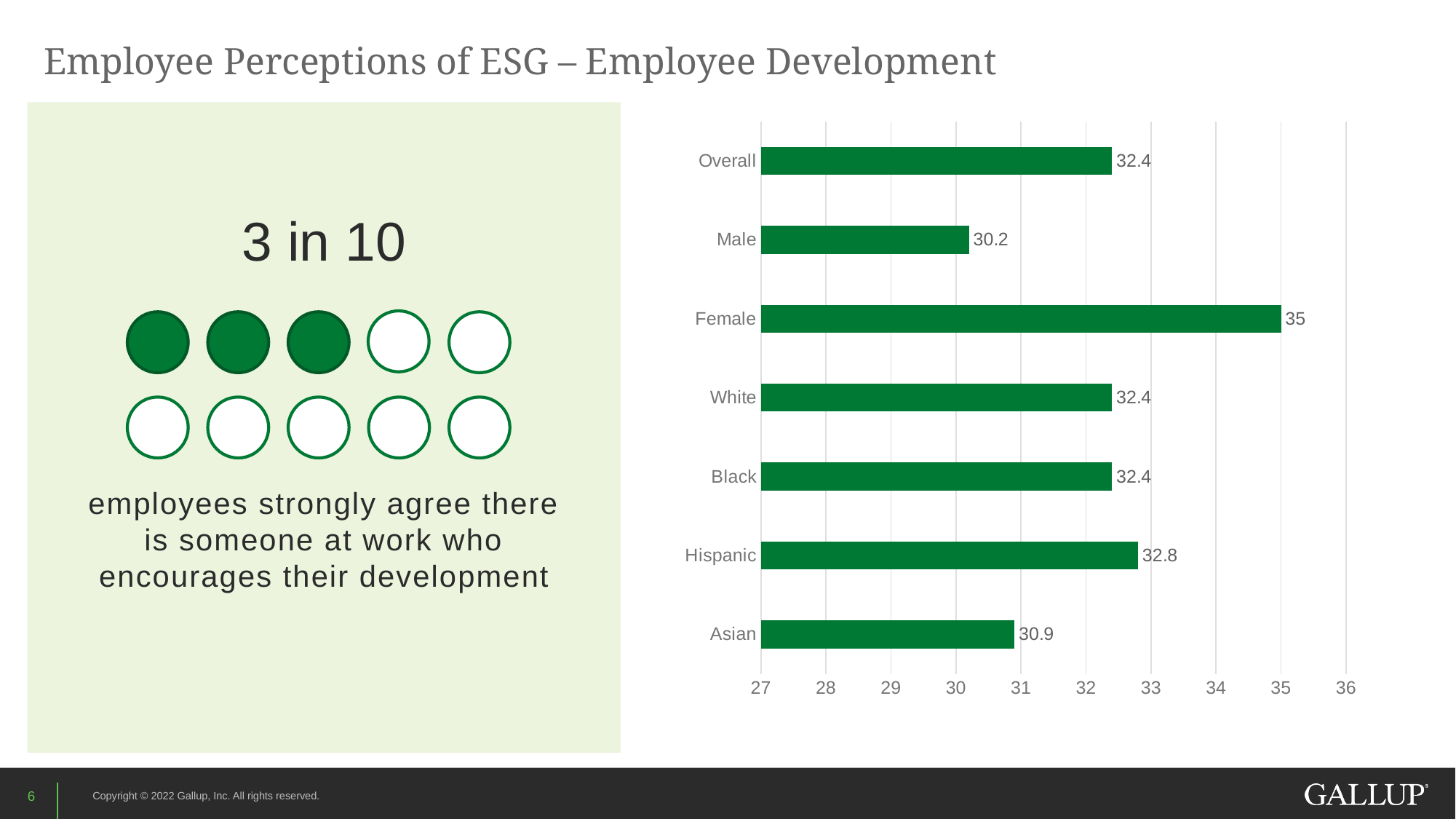
Which is larger, the value for Hispanic or the value for Asian? Hispanic What is the difference between the values for Hispanic and Overall? 0.4 What is the difference between the values for Female and Male? 4.8 What is the value for Male? 30.2 What is the value for Female? 35 How many categories are shown in the chart? 7 What is the value for Hispanic? 32.8 Which category has the lowest value? Male What is the value for Asian? 30.9 Which category has the highest value? Female Is the value for Overall greater or less than 32? greater What kind of chart is shown on the slide? bar chart